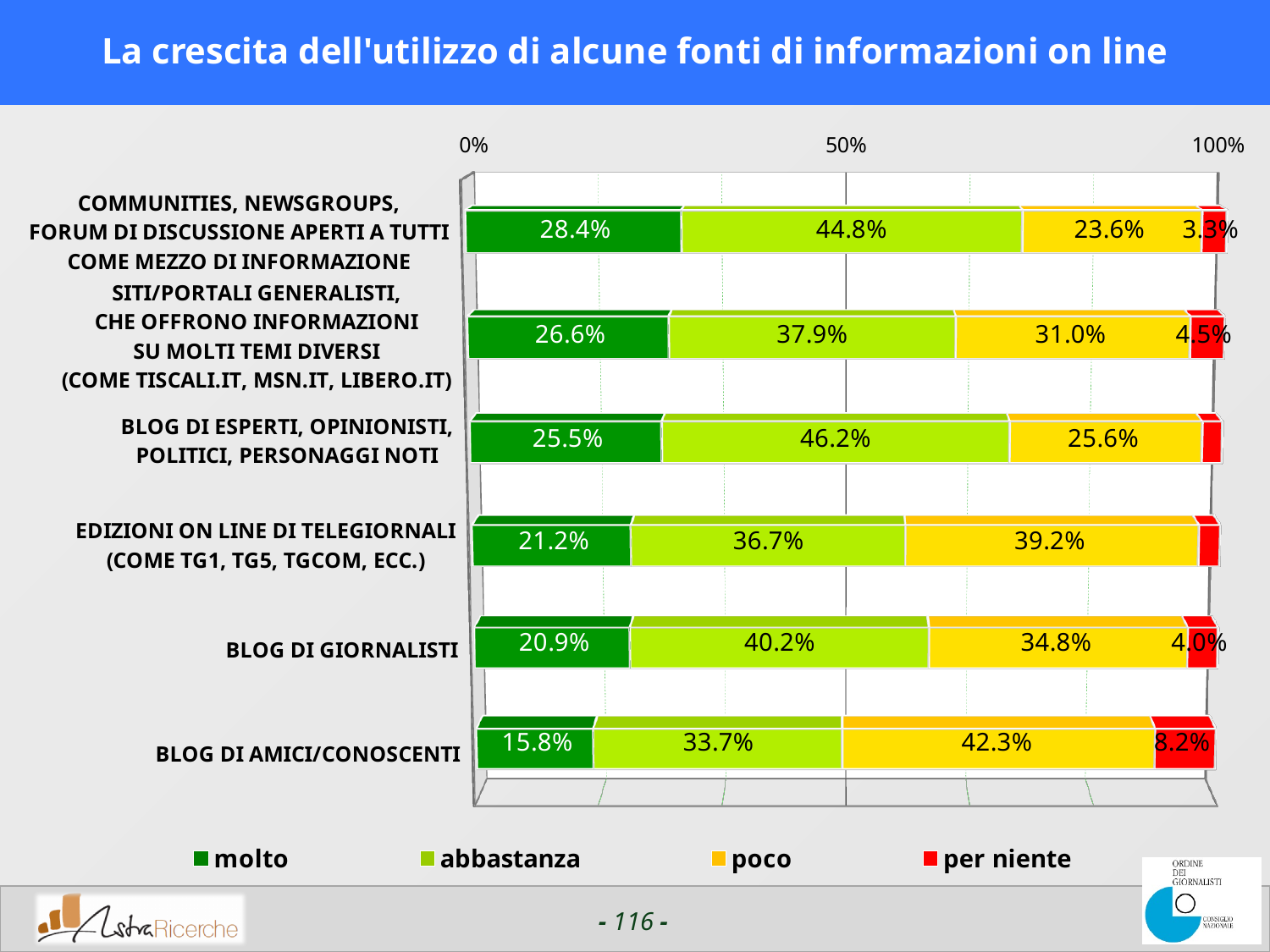
What kind of chart is shown on the slide? Stacked bar chart Which colour represents the 'per niente' series in the legend? Red How many series does the legend list? 4 What is the 'molto' value for BLOG DI GIORNALISTI? 20.9% What is the 'abbastanza' value for BLOG DI ESPERTI, OPINIONISTI, POLITICI, PERSONAGGI NOTI? 46.2% What is the difference in percentage points between the 'abbastanza' value for COMMUNITIES, NEWSGROUPS, FORUM DI DISCUSSIONE and the 'abbastanza' value for SITI/PORTALI GENERALISTI? 6.9 What is the 'per niente' value for BLOG DI AMICI/CONOSCENTI? 8.2% Which category has the lowest 'molto' value? BLOG DI AMICI/CONOSCENTI How many categories are shown in the chart? 6 Which is larger: the 'poco' value for BLOG DI AMICI/CONOSCENTI or the 'poco' value for BLOG DI GIORNALISTI? BLOG DI AMICI/CONOSCENTI What is the 'poco' value for EDIZIONI ON LINE DI TELEGIORNALI? 39.2% Which category has the highest 'molto' value? COMMUNITIES, NEWSGROUPS, FORUM DI DISCUSSIONE APERTI A TUTTI COME MEZZO DI INFORMAZIONE